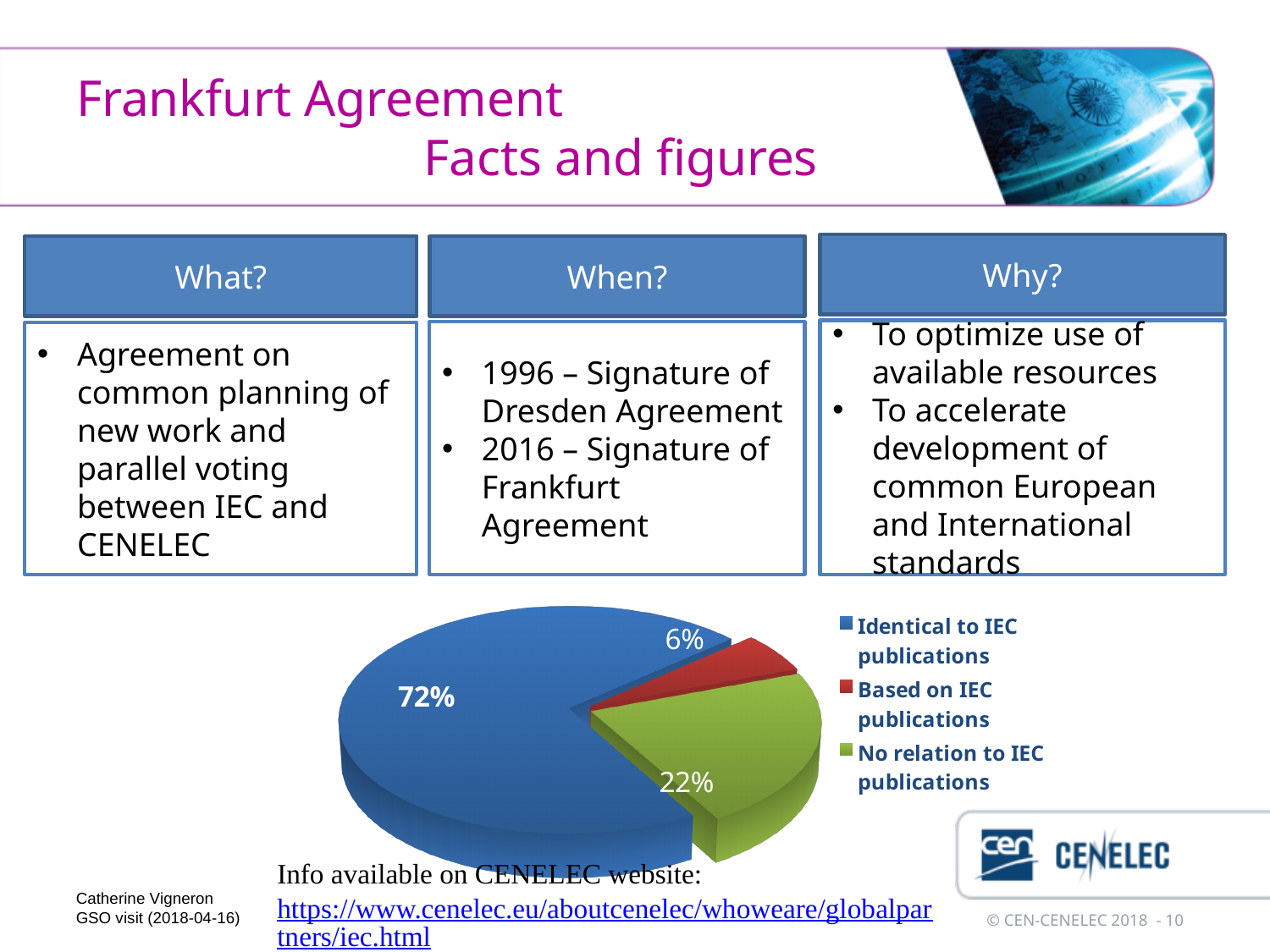
Which category has the smallest slice of the pie? Based on IEC publications How many slices does the pie chart have? 3 How many entries does the pie chart legend list? 3 Which is larger: the "No relation to IEC publications" slice or the "Based on IEC publications" slice? No relation to IEC publications What is the difference in percentage points between the "Identical to IEC publications" slice and the "No relation to IEC publications" slice? 50 What kind of chart is shown at the bottom of the slide? pie chart What share of the pie is labelled "Identical to IEC publications"? 72% What share of the pie is labelled "No relation to IEC publications"? 22% What colour is the "No relation to IEC publications" slice in the pie chart? green What colour is the "Identical to IEC publications" slice in the pie chart? blue What share of the pie is labelled "Based on IEC publications"? 6% Which category has the largest slice of the pie? Identical to IEC publications